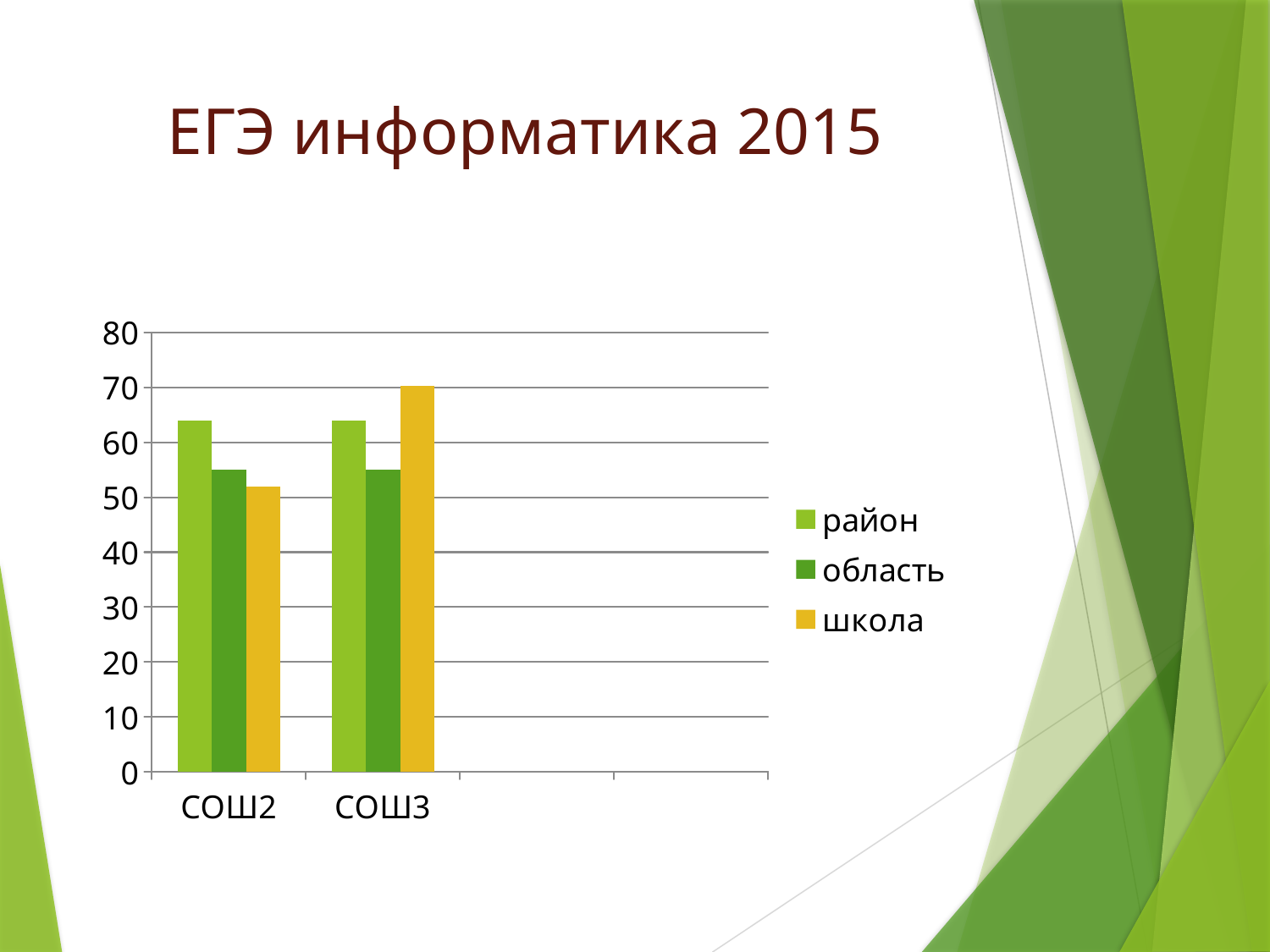
Is the value for область at СОШ3 greater or less than 60? less Is the value for район at СОШ2 greater or less than 60? greater Which is larger: the школа value for СОШ2 or the школа value for СОШ3? СОШ3 How many series does the legend list? 3 Is the value for школа at СОШ2 greater or less than 60? less What is the title of the slide? ЕГЭ информатика 2015 Which series has the highest value for СОШ3? школа Which series has the lowest value for СОШ2? школа How many categories are shown on the x axis? 2 What kind of chart is shown on the slide? bar chart Which series is shown in yellow in the legend? школа